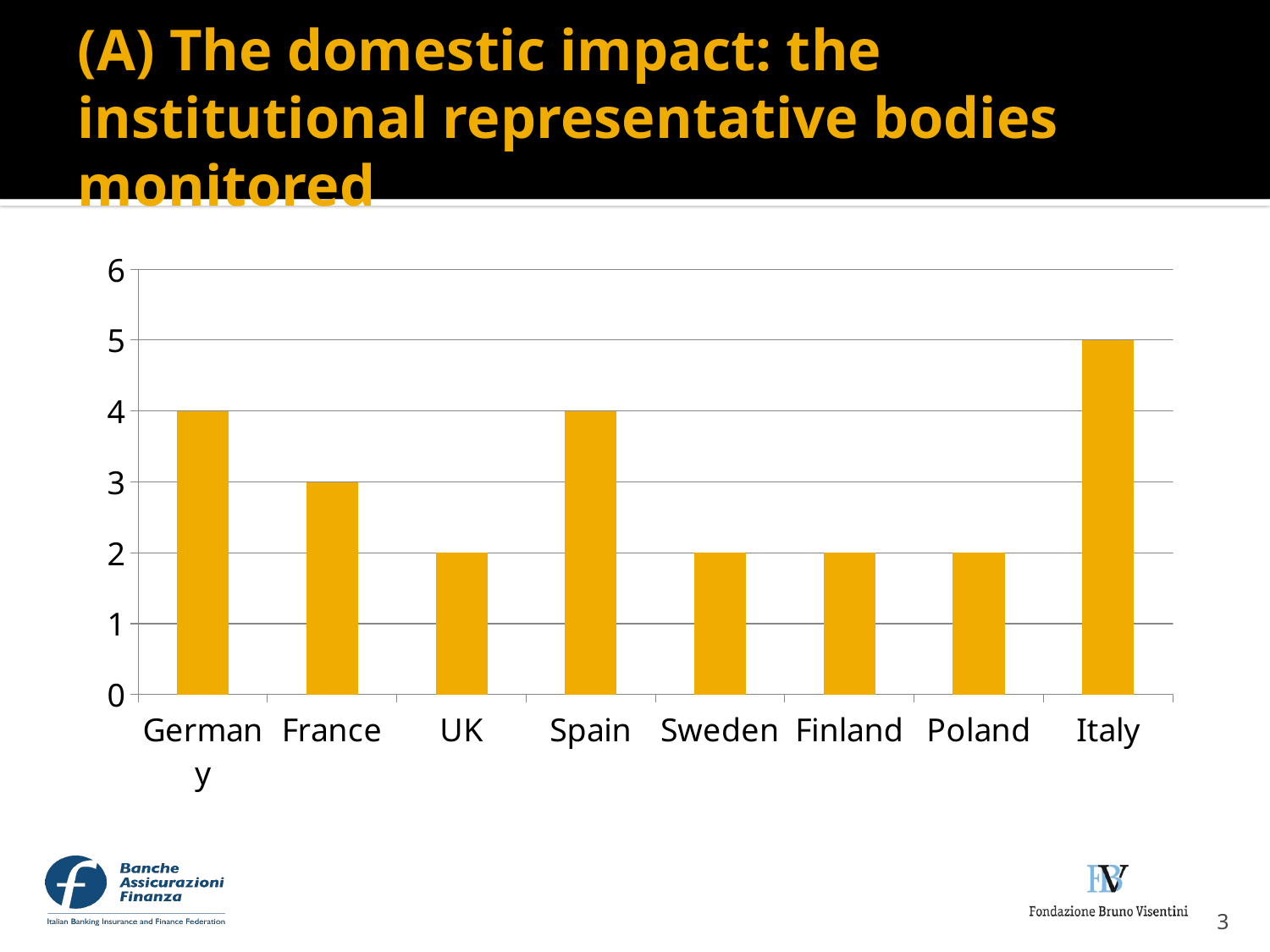
Is the value for Italy greater or less than 4? greater How many countries are shown on the x axis? 8 How many countries have a value of 2? 4 Which country has the highest value? Italy What kind of chart is shown on the slide? Bar chart Which is larger, the value for Spain or the value for Sweden? Spain What is the value for France? 3 What is the value for Germany? 4 What is the difference between the values for Italy and France? 2 What is the value for Poland? 2 What is the highest value shown on the y axis? 6 What is the value for Italy? 5